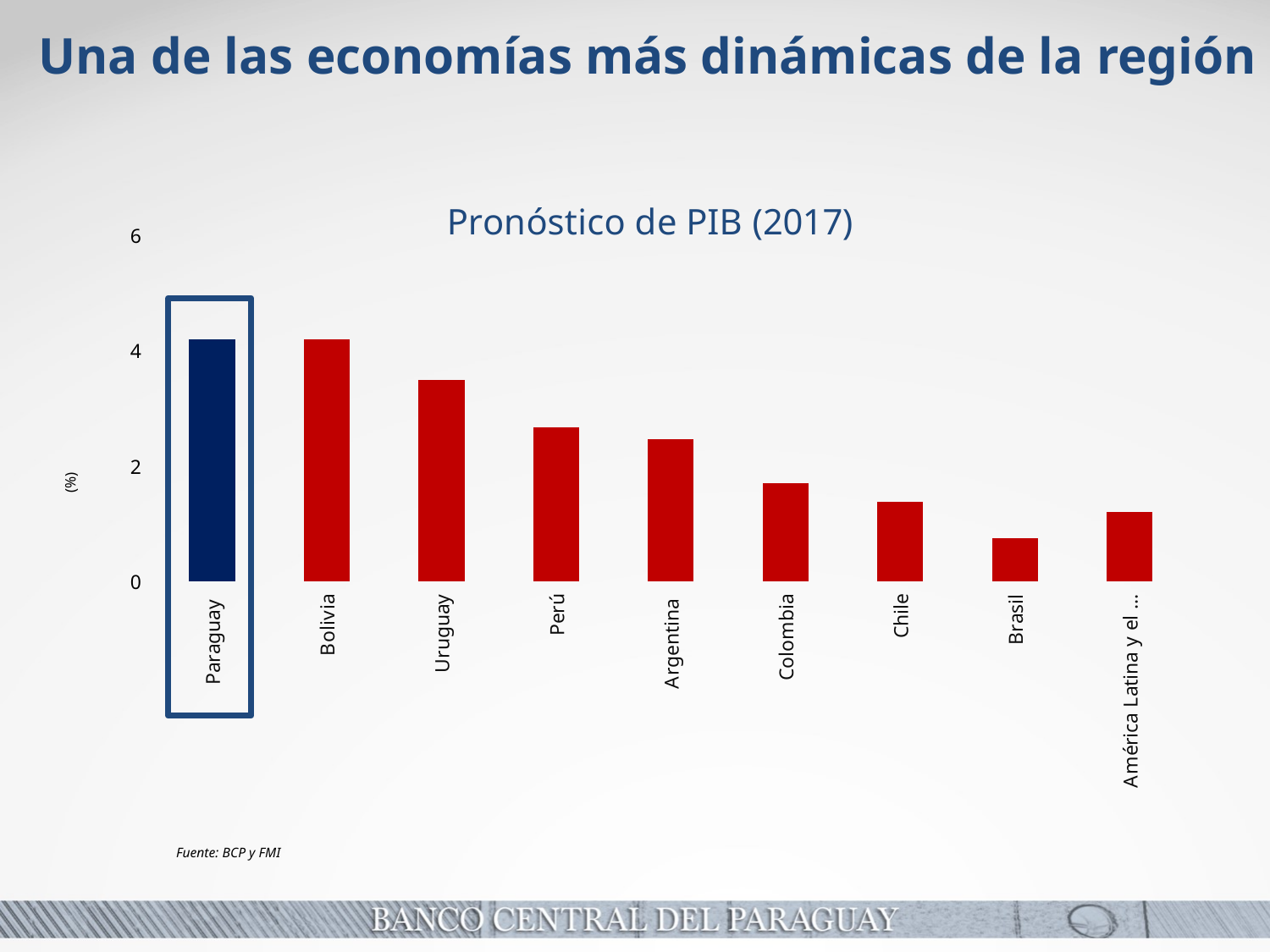
Is the value for Uruguay greater or less than 2? greater What kind of chart is shown on the slide? bar chart Do the bar values generally rise or fall from left to right across the chart? fall Which country's bar is coloured dark blue instead of red? Paraguay Which has a larger value, Colombia or Chile? Colombia Is the value for Colombia greater or less than 2? less Is the value for Uruguay greater or less than 4? less How many countries or regions are plotted in the chart? 9 Which has a larger value, Uruguay or Perú? Uruguay What is the title of the chart? Pronóstico de PIB (2017) Which category has the lowest value in the chart? Brasil